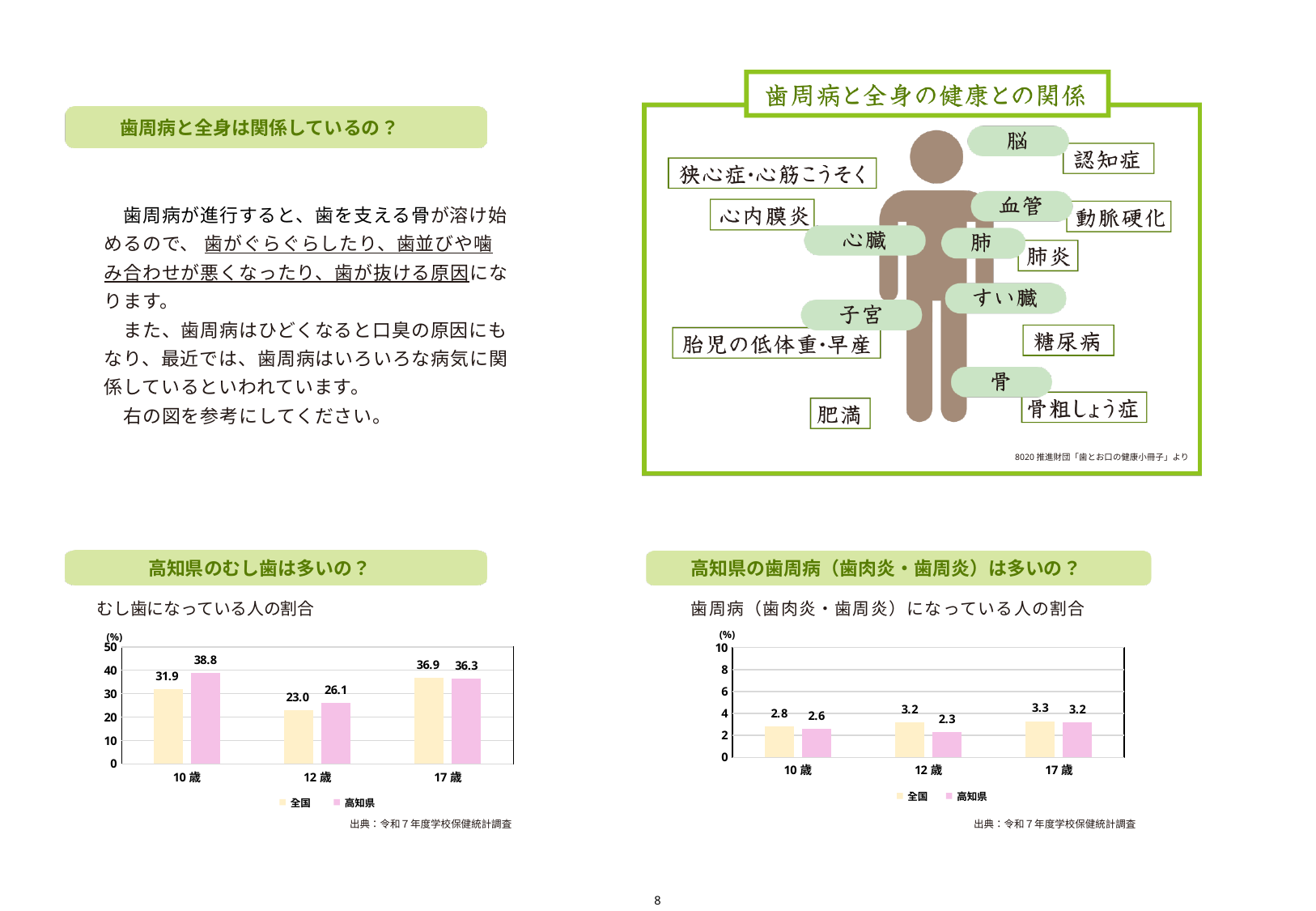
In the chart titled むし歯になっている人の割合, which age group has the highest value for 高知県? 10 歳 In the chart titled 歯周病（歯肉炎・歯周炎）になっている人の割合, what is the difference between the 全国 and 高知県 values at 12 歳? 0.9 How many series does the legend list in the chart titled 歯周病（歯肉炎・歯周炎）になっている人の割合? 2 In the chart titled 歯周病（歯肉炎・歯周炎）になっている人の割合, what is the value for 高知県 at 12 歳? 2.3 In the chart titled 歯周病（歯肉炎・歯周炎）になっている人の割合, which age group has the lowest value for 高知県? 12 歳 What kind of chart is the chart titled むし歯になっている人の割合? bar chart In the chart titled むし歯になっている人の割合, what is the value for 高知県 at 10 歳? 38.8 In the chart titled むし歯になっている人の割合, what is the difference between the 高知県 and 全国 values at 10 歳? 6.9 In the chart titled 歯周病（歯肉炎・歯周炎）になっている人の割合, what is the value for 全国 at 17 歳? 3.3 In the chart titled むし歯になっている人の割合, which age group has the lowest value for 全国? 12 歳 In the chart titled むし歯になっている人の割合, what is the value for 全国 at 12 歳? 23.0 In the chart titled むし歯になっている人の割合, which is larger at 12 歳, 全国 or 高知県? 高知県